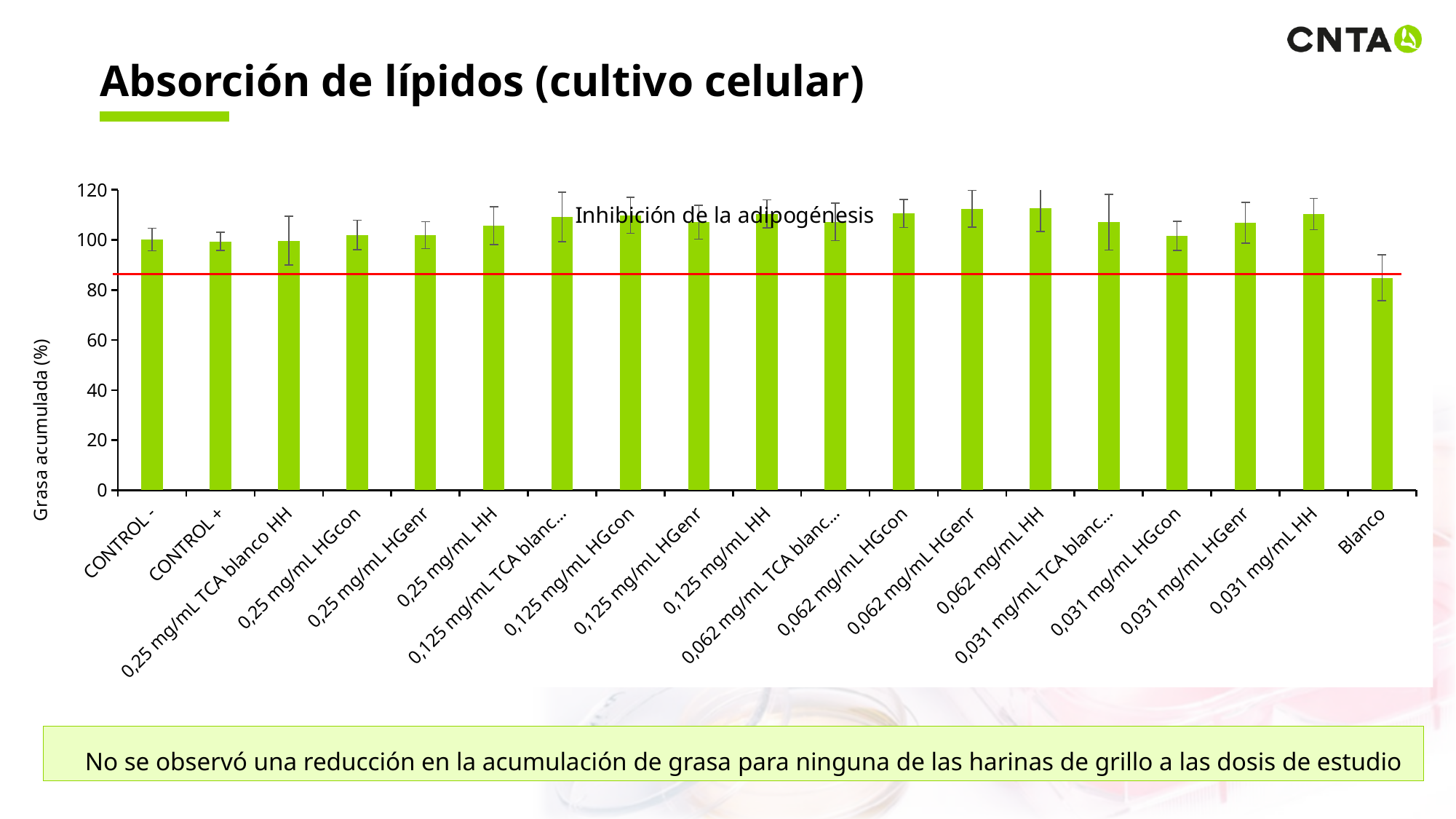
What kind of chart is shown on the slide? bar chart Is the value for 0,062 mg/mL HH greater or less than 100? greater How many categories (bars) are plotted in the chart? 19 Which has a higher value, 0,062 mg/mL HH or 0,031 mg/mL HGcon? 0,062 mg/mL HH What is the label of the vertical axis of the chart? Grasa acumulada (%) Is the value for Blanco greater or less than 100? less Which has a higher value, CONTROL - or Blanco? CONTROL - What is the title printed inside the chart area? Inhibición de la adipogénesis Which category has the lowest accumulated fat value in the chart? Blanco Is the value for CONTROL - greater or less than 80? greater